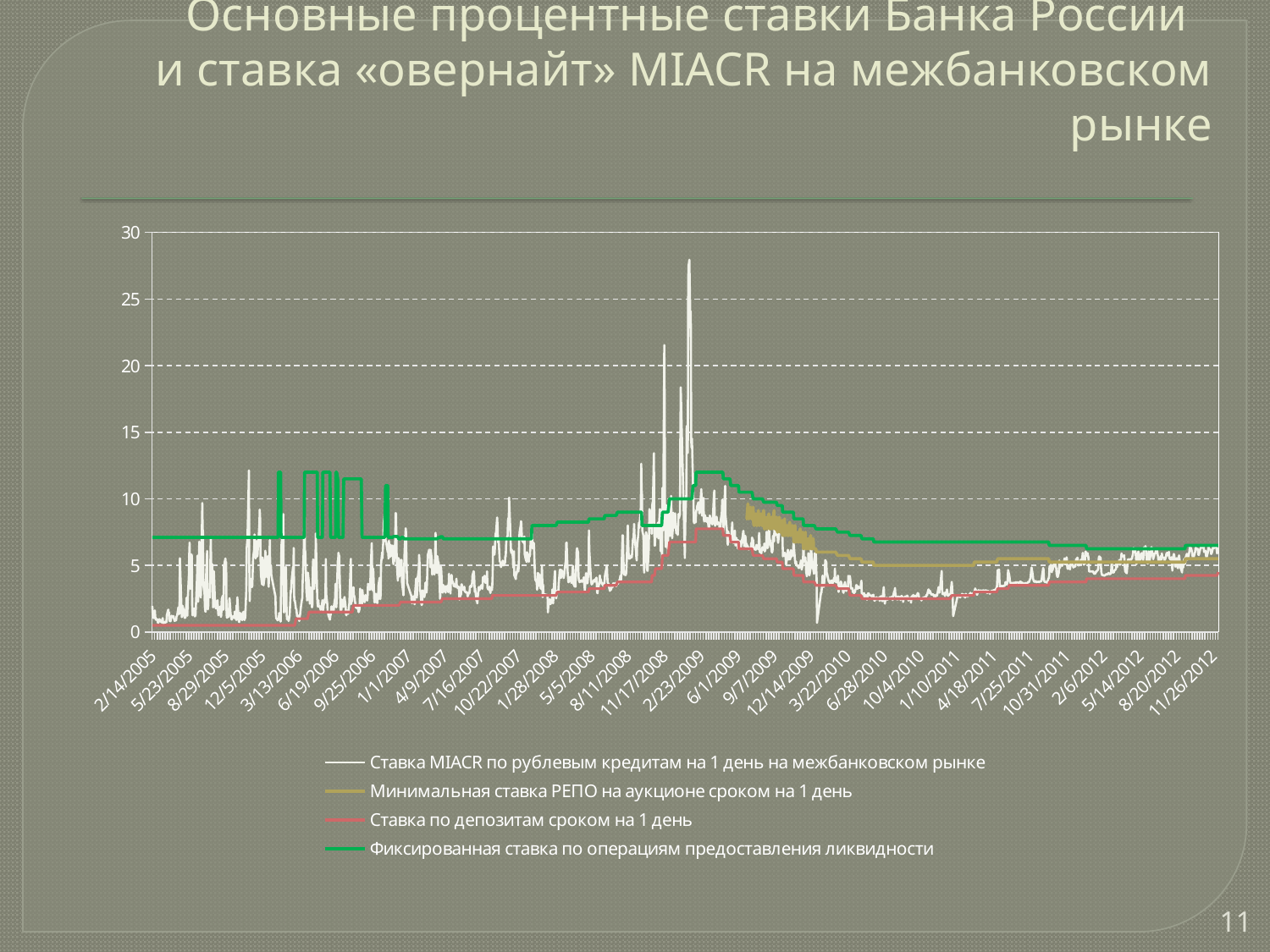
Is the peak value of the MIACR rate (Ставка MIACR по рублевым кредитам на 1 день) greater or less than 25? greater What kind of chart is shown on the slide? line chart Which series reaches the highest value anywhere on the chart? Ставка MIACR по рублевым кредитам на 1 день на межбанковском рынке At 2/14/2005, which is higher: «Фиксированная ставка по операциям предоставления ликвидности» or «Ставка по депозитам сроком на 1 день»? Фиксированная ставка по операциям предоставления ликвидности What colour is the line for «Фиксированная ставка по операциям предоставления ликвидности»? green What is the title of the chart on the slide? Основные процентные ставки Банка России и ставка «овернайт» MIACR на межбанковском рынке Does «Ставка по депозитам сроком на 1 день» rise or fall between 2/14/2005 and 2/23/2009? rise Is the value of «Ставка по депозитам сроком на 1 день» at 11/26/2012 greater or less than 5? less How many series does the legend list? 4 Is the value of «Фиксированная ставка по операциям предоставления ликвидности» at 11/26/2012 greater or less than 10? less